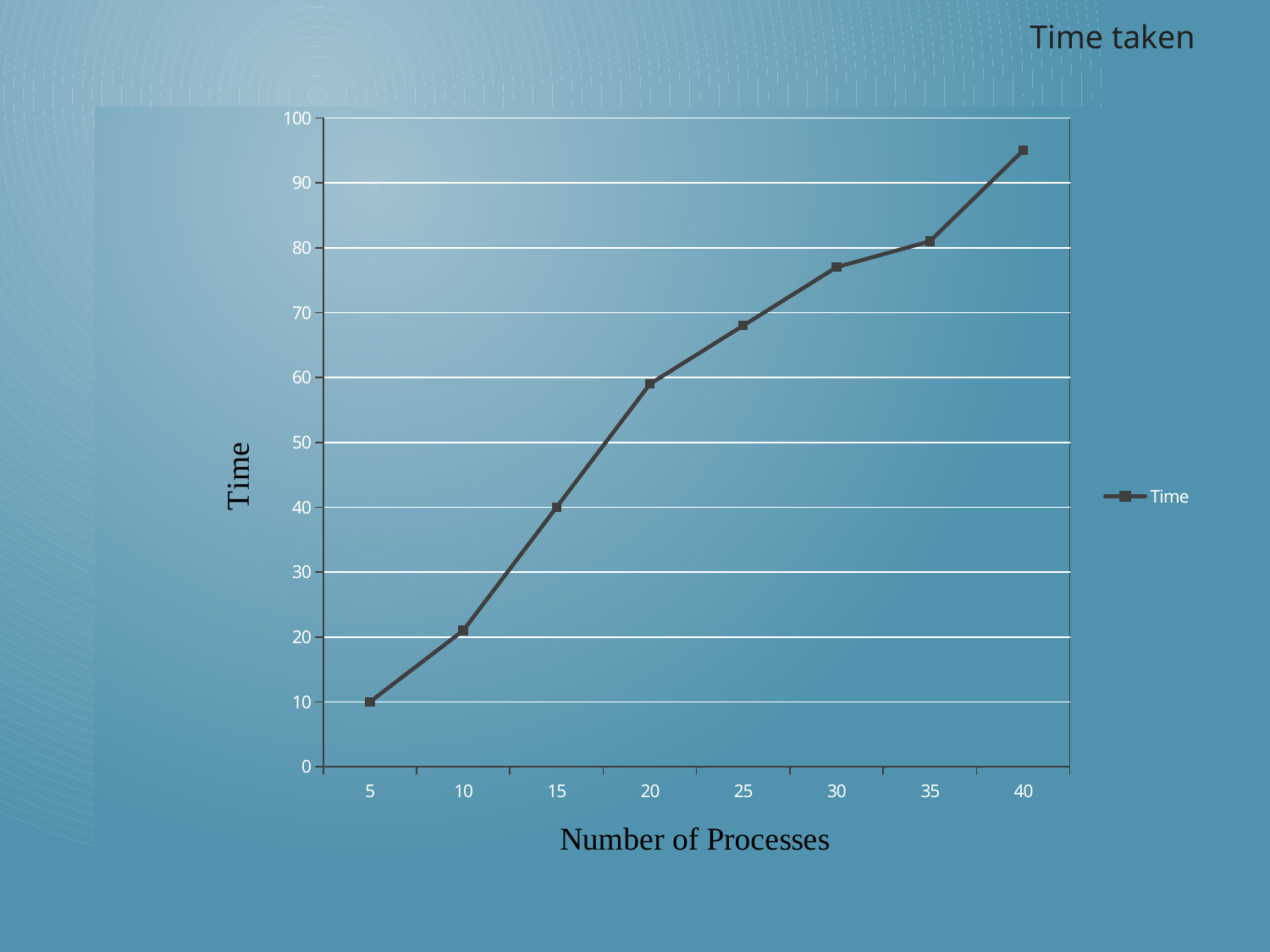
What is the Time value when the Number of Processes is 5? 10 Which has a larger Time value: 10 processes or 30 processes? 30 processes Is the Time value for 20 processes greater or less than 50? greater What kind of chart is shown on the slide? line chart At which Number of Processes is the Time lowest? 5 How many series does the legend list? 1 What is the title of the chart? Time taken Is the Time value for 40 processes greater or less than 90? greater At which Number of Processes is the Time highest? 40 What is the Time value when the Number of Processes is 15? 40 How many data points are plotted on the line? 8 Does the Time rise or fall as the Number of Processes increases? rise